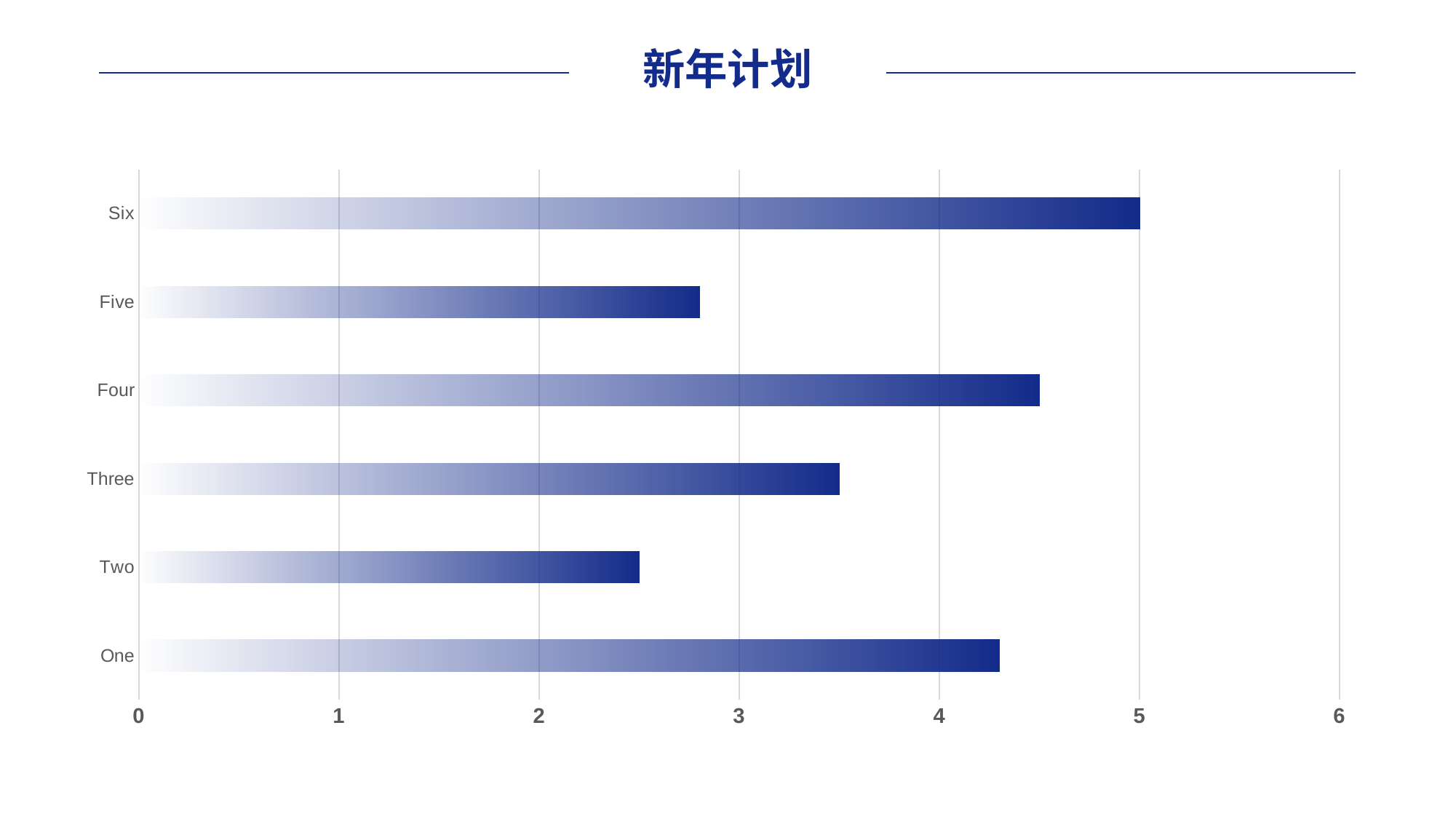
Is the value for Four greater or less than 4? greater Is the value for Five greater or less than 3? less What is the value for Six? 5 Which category has the highest value? Six Is the value for Two greater or less than 3? less Which is larger, the value for Six or the value for Four? Six How many categories are plotted in the chart? 6 What kind of chart is shown on the slide? bar chart What is the title of the slide? 新年计划 Which category has the lowest value? Two Which is larger, the value for Three or the value for Five? Three